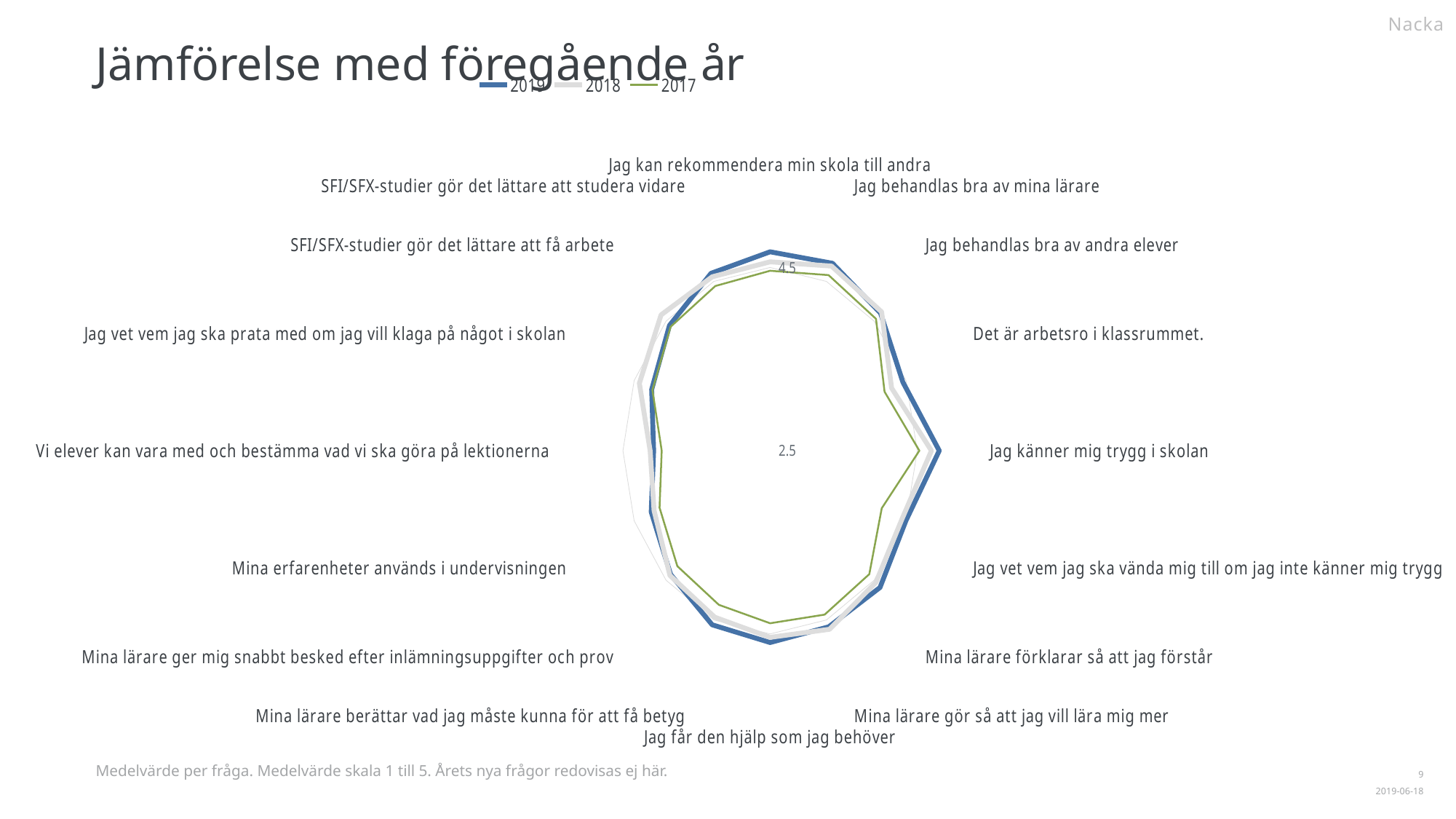
Is the 2017 value for 'Mina erfarenheter används i undervisningen' greater or less than 4.5? less How many categories (questions) are plotted around the radar chart? 16 What kind of chart is shown on the slide? Radar chart Is the 2019 value for 'Vi elever kan vara med och bestämma vad vi ska göra på lektionerna' greater or less than 4.5? less Which years are listed in the chart legend? 2019, 2018, 2017 What is the title of the slide containing the chart? Jämförelse med föregående år How many series does the legend list? 3 For 'Jag känner mig trygg i skolan', which series has the larger value, 2019 or 2017? 2019 Is the 2017 value for 'Jag vet vem jag ska prata med om jag vill klaga på något i skolan' greater or less than 4.5? less For 'Mina lärare ger mig snabbt besked efter inlämningsuppgifter och prov', which series has the larger value, 2019 or 2017? 2019 For 'Jag kan rekommendera min skola till andra', which series has the larger value, 2019 or 2017? 2019